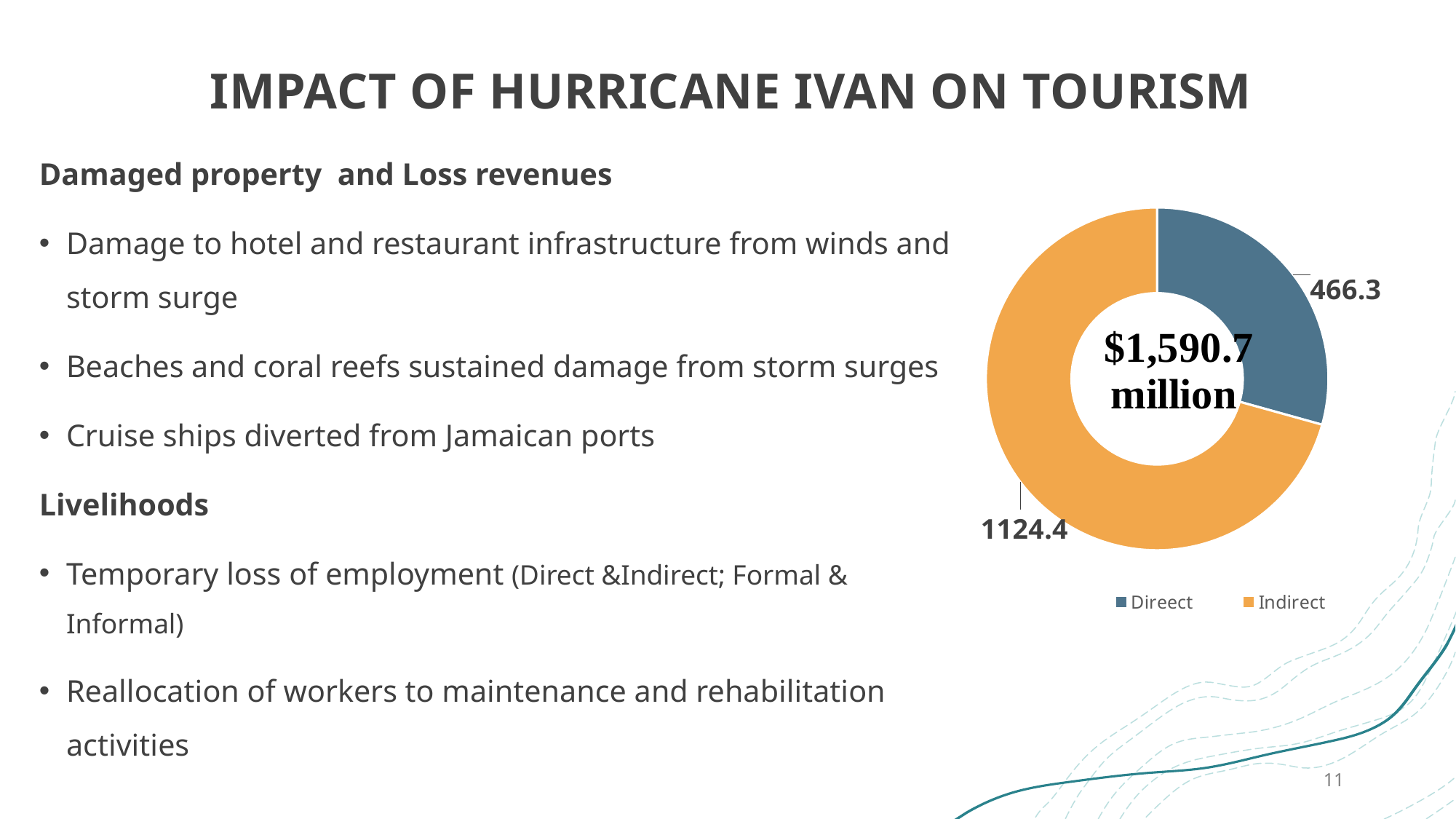
What is the value for the Indirect slice of the pie chart? 1124.4 Which is larger in the pie chart, Direct or Indirect? Indirect Which slice of the pie chart is the largest? Indirect What is the difference between the Indirect and Direct values in the pie chart? 658.1 What colour is the Indirect slice of the pie chart? orange Which slice of the pie chart is the smallest? Direct How many slices does the pie chart have? 2 What is the value for the Direct slice of the pie chart? 466.3 How many entries does the pie chart's legend list? 2 What kind of chart is shown on the slide? doughnut chart What total is printed in the centre of the pie chart? $1,590.7 million What colour is the Direct slice of the pie chart? blue